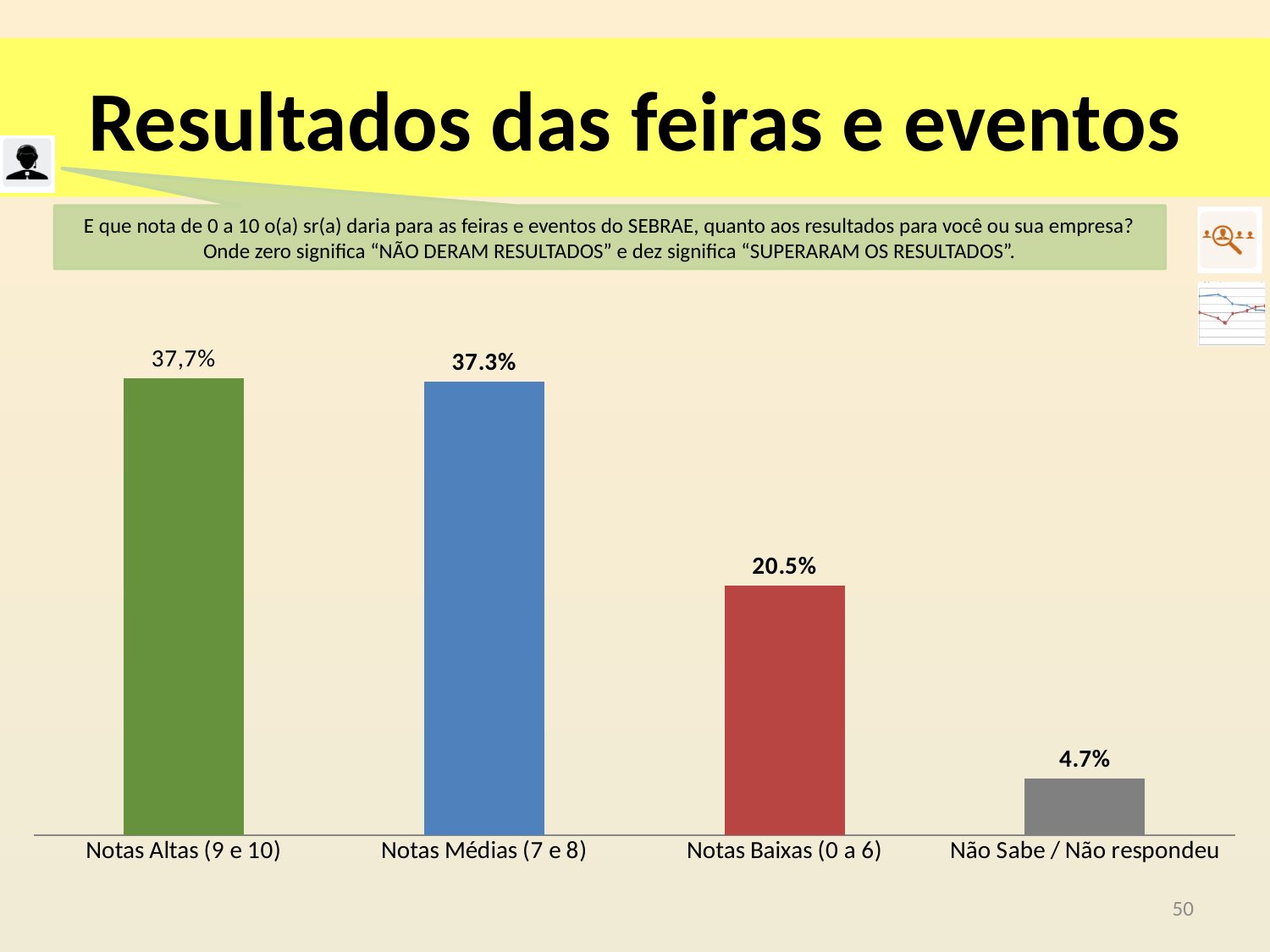
What is the value shown for Não Sabe / Não respondeu? 4.7% How many categories are shown in the chart? 4 Do the values rise or fall from left to right across the categories? Fall What is the value shown for Notas Altas (9 e 10)? 37,7% Which is larger, the value for Notas Médias (7 e 8) or the value for Notas Baixas (0 a 6)? Notas Médias (7 e 8) What is the value shown for Notas Médias (7 e 8)? 37.3% What kind of chart is shown on the slide? Bar chart What is the difference between the values for Notas Baixas (0 a 6) and Não Sabe / Não respondeu? 15.8 percentage points What is the difference between the values for Notas Médias (7 e 8) and Notas Baixas (0 a 6)? 16.8 percentage points Which category has the highest value? Notas Altas (9 e 10) What is the value shown for Notas Baixas (0 a 6)? 20.5% Which category has the lowest value? Não Sabe / Não respondeu